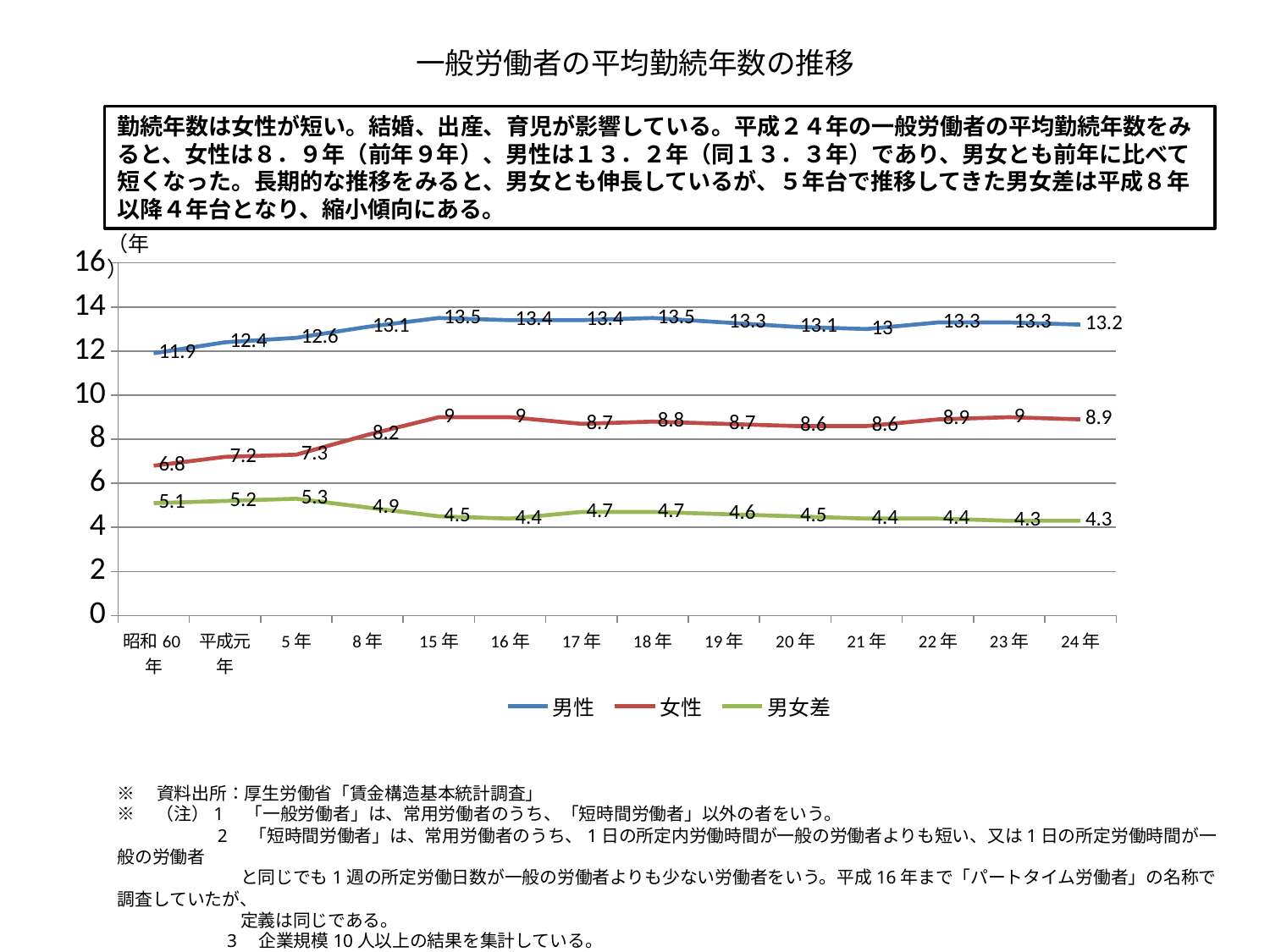
How many series does the legend list? 3 In which year is the 男女差 series at its highest? 5年 What is the value for 女性 in 平成8年? 8.2 What is the difference between the 男性 and 女性 values in 平成24年? 4.3 Which is larger, the 女性 value in 平成15年 or in 平成17年? 平成15年 What kind of chart is shown on the slide? line chart Does the 男性 series rise or fall from 昭和60年 to 平成15年? rise In which year is the 女性 series at its lowest? 昭和60年 Is the value for 男性 in 平成元年 greater or less than 12? greater What is the value for 男女差 in 平成20年? 4.5 How many years are plotted on the x axis? 14 What is the value for 男性 in 平成24年? 13.2